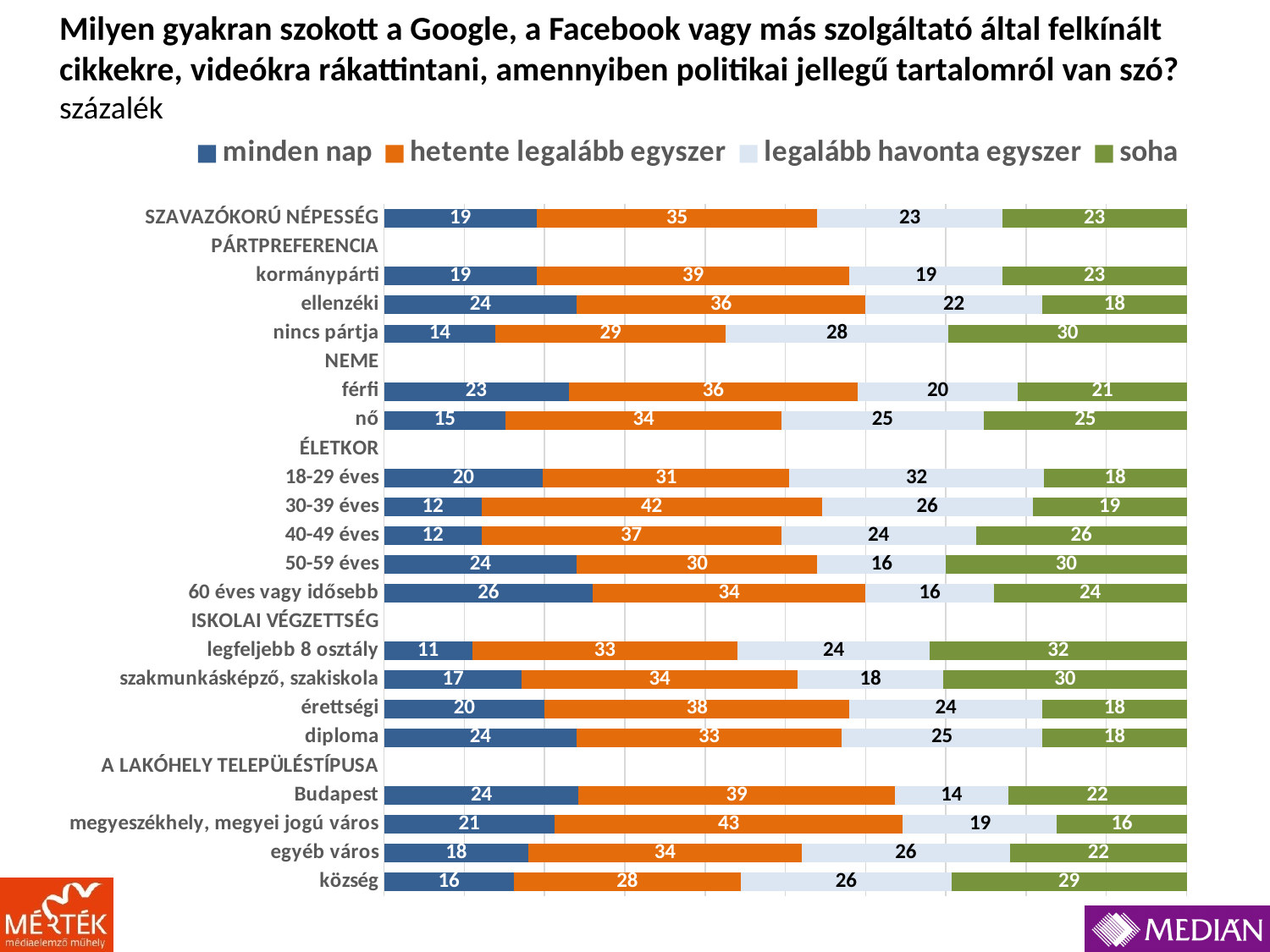
Which category has the highest 'soha' value? legfeljebb 8 osztály What kind of chart is shown on the slide? stacked bar chart How many series does the legend list? 4 What is the 'hetente legalább egyszer' value for 'megyeszékhely, megyei jogú város'? 43 Which legend entry is shown in green? soha What is the 'legalább havonta egyszer' value for 'Budapest'? 14 Which category has the highest 'minden nap' value? 60 éves vagy idősebb Which is larger: the 'hetente legalább egyszer' value for 'kormánypárti' or for 'ellenzéki'? kormánypárti What is the 'minden nap' value for 'SZAVAZÓKORÚ NÉPESSÉG'? 19 What is the difference between the 'minden nap' values for 'férfi' and 'nő'? 8 Which category has the lowest 'minden nap' value? legfeljebb 8 osztály What is the 'soha' value for 'nincs pártja'? 30